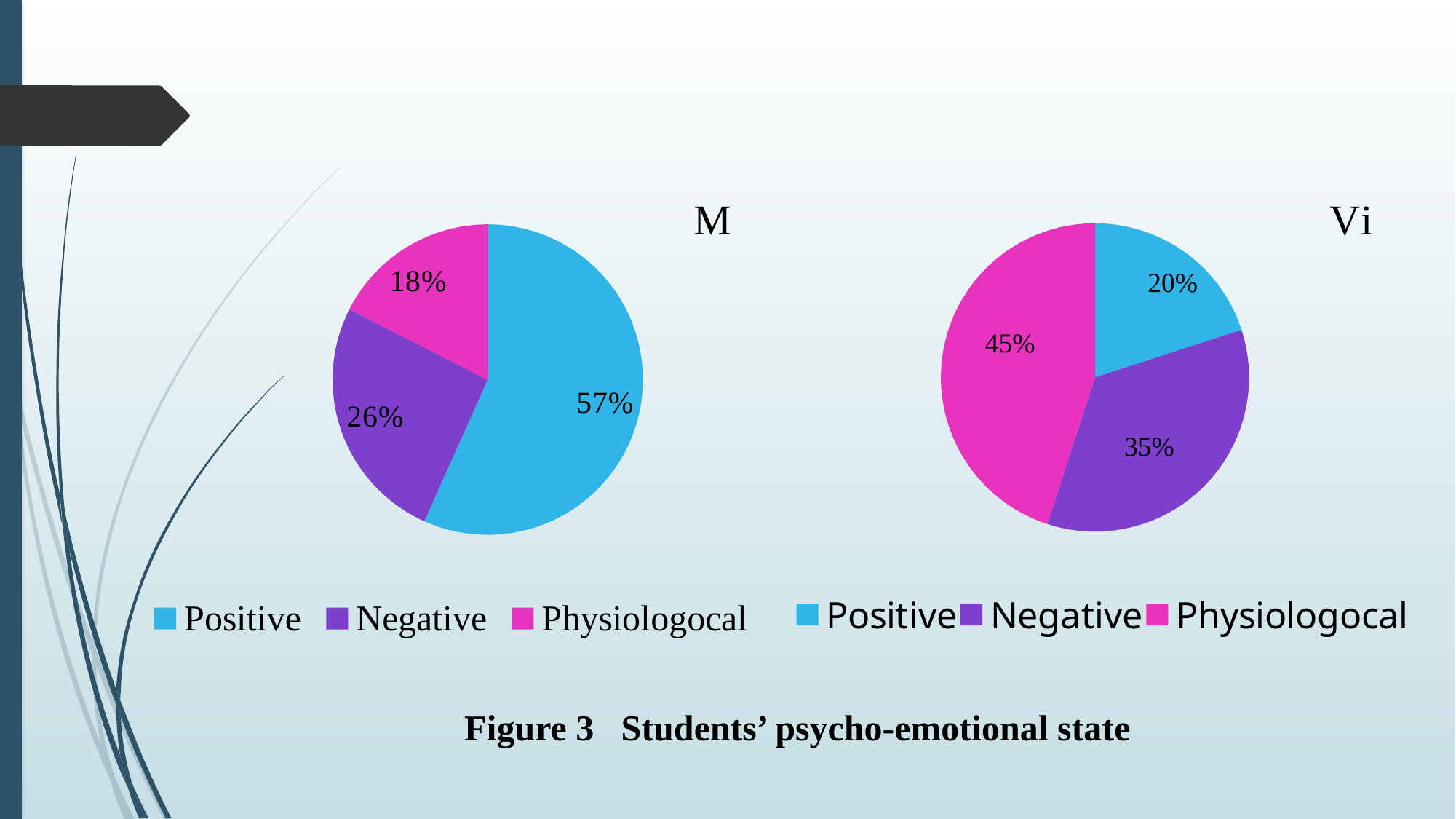
What is the figure caption below the two charts? Figure 3 Students' psycho-emotional state In the pie chart titled Vi, what is the difference between the Physiologocal and Negative shares? 10% Which is larger: the Negative share in the M chart or the Negative share in the Vi chart? Vi How many slices does the pie chart titled M have? 3 In the pie chart titled M, what percentage is Negative? 26% In the pie chart titled Vi, which category has the smallest share? Positive In the pie chart titled M, what is the difference between the Positive and Negative shares? 31% In the pie chart titled Vi, what percentage is Positive? 20% In the pie chart titled Vi, what percentage is Physiologocal? 45% In the pie chart titled M, what percentage is Positive? 57% What type of chart is the chart titled Vi? Pie chart In the pie chart titled M, which category has the largest share? Positive